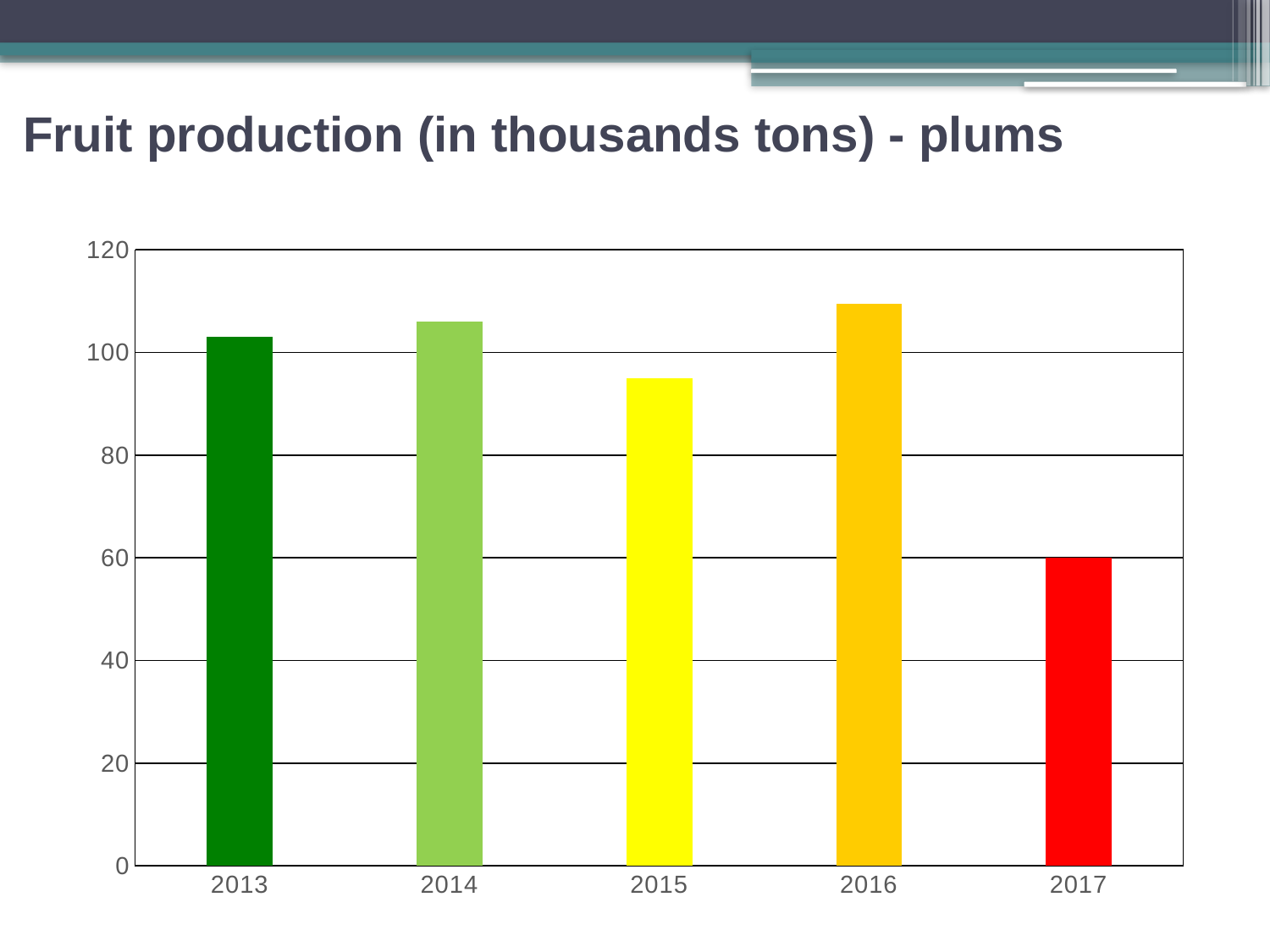
Which year has the lowest plum production? 2017 How many years are shown on the x axis of the chart? 5 What type of chart is shown on the slide? bar chart What is the title of the chart on the slide? Fruit production (in thousands tons) - plums Is the value for 2013 greater or less than 100? greater Which is larger, the value for 2013 or the value for 2017? 2013 Which year has the highest plum production? 2016 Is the value for 2015 greater or less than 100? less Is the value for 2014 greater or less than 100? greater Which is larger, the value for 2015 or the value for 2016? 2016